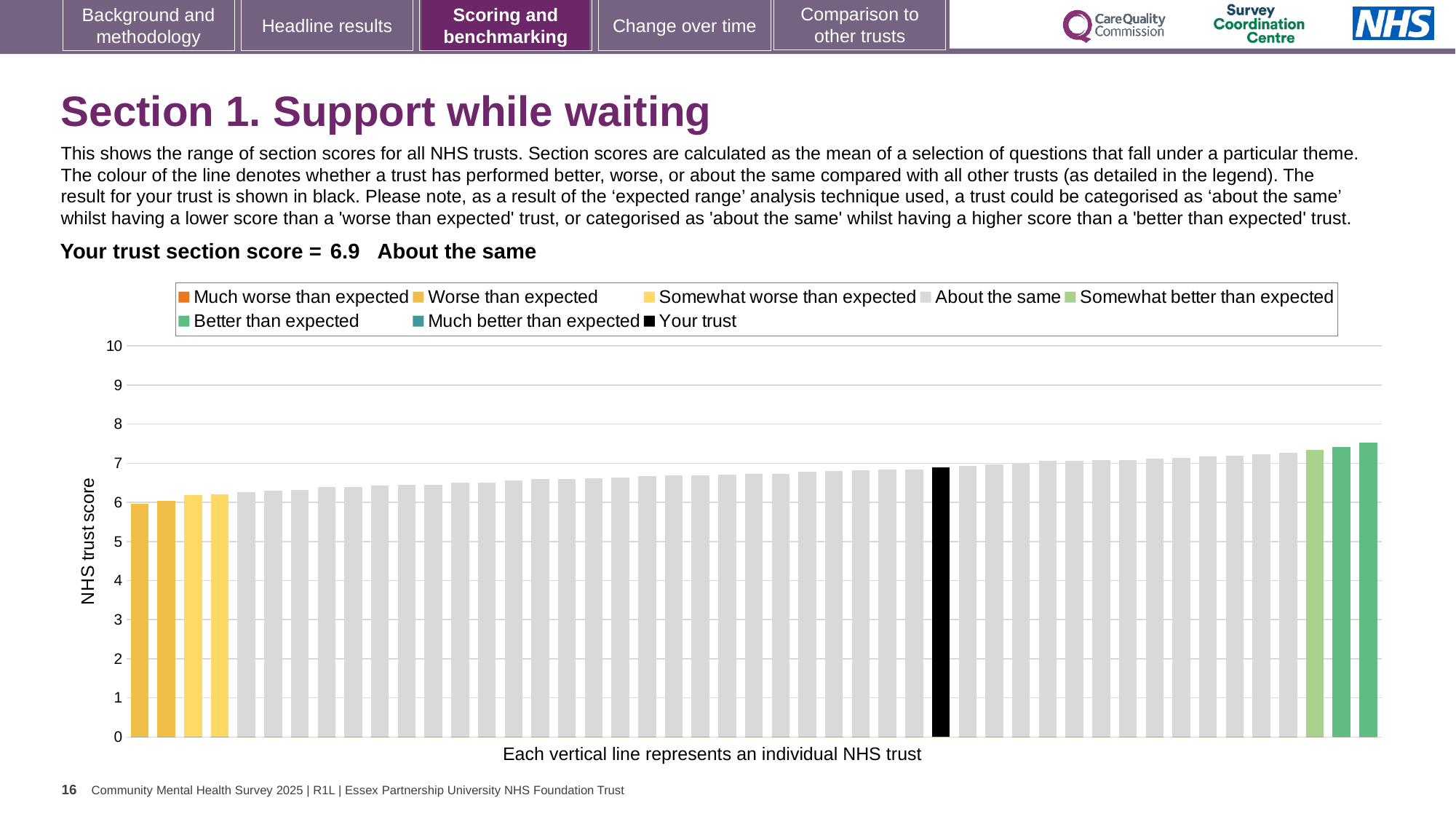
Which performance category is your trust placed in for this section? About the same What kind of chart is shown on the slide? Bar chart Is the value of the lowest bar in the chart greater or less than 7? less Which legend category do the tallest bars on the right of the chart belong to? Better than expected Is the value for your trust's bar greater or less than 6? greater Is the value of the highest bar in the chart greater or less than 7? greater What is the section score for your trust shown on the slide? 6.9 How many entries does the chart legend list? 8 Do the bar values rise or fall from left to right along the x axis? Rise What colour is the bar representing your trust? Black What is the label on the vertical axis of the chart? NHS trust score